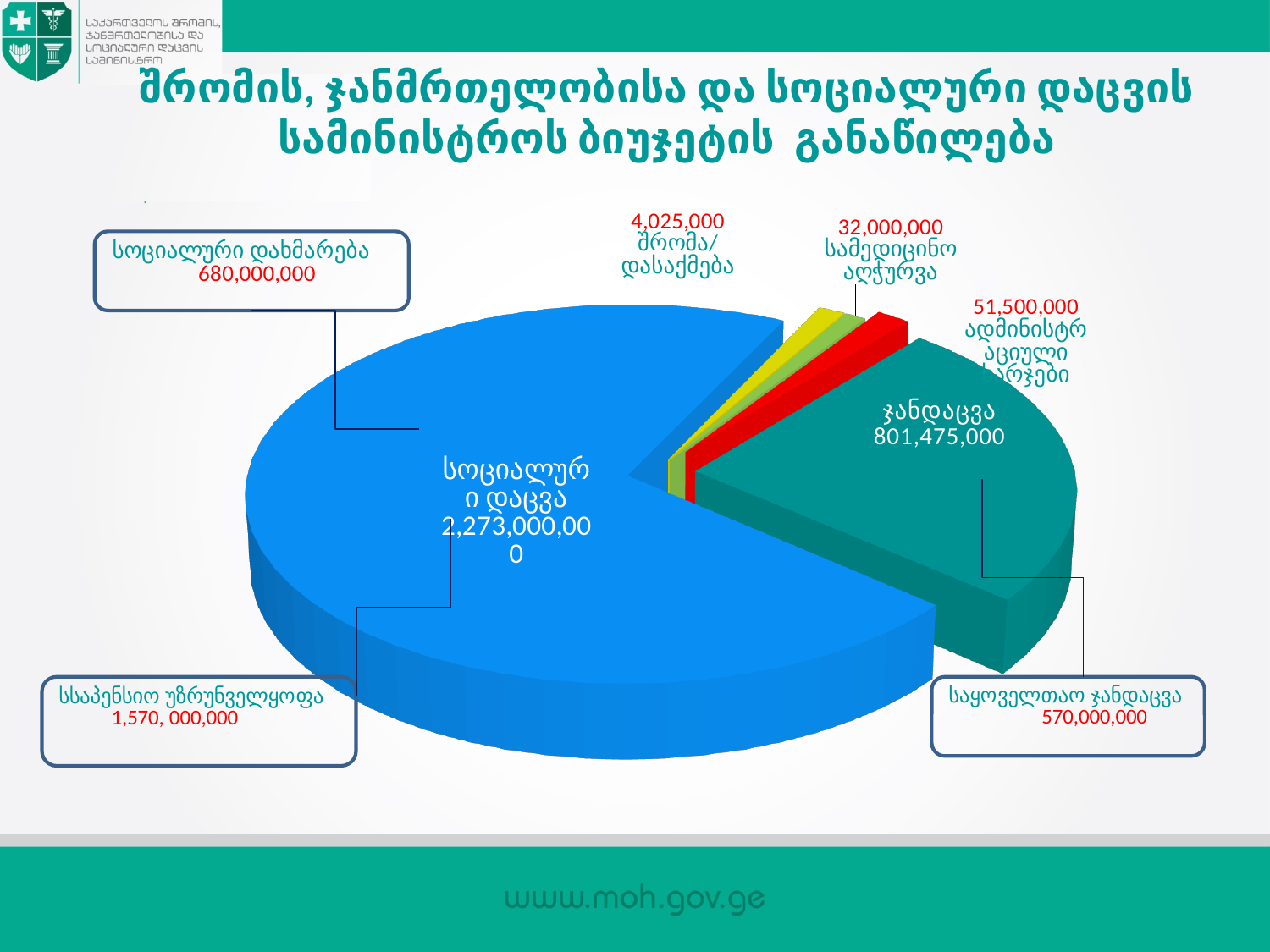
Which is larger, ადმინისტრაციული ხარჯები or სამედიცინო აღჭურვა? ადმინისტრაციული ხარჯები Which slice of the pie chart is the largest? სოციალური დაცვა What is the difference between the სოციალური დაცვა value and the ჯანდაცვა value? 1,471,525,000 What is the value shown for შრომა/დასაქმება? 4,025,000 How many slices does the pie chart have? 5 Which slice of the pie chart is the smallest? შრომა/დასაქმება What is the value shown for სამედიცინო აღჭურვა? 32,000,000 What is the value shown for ადმინისტრაციული ხარჯები? 51,500,000 What value is shown in the callout box for საყოველთაო ჯანდაცვა? 570,000,000 What is the value shown for the ჯანდაცვა slice? 801,475,000 What type of chart is shown on the slide? pie chart What is the value shown for the სოციალური დაცვა slice? 2,273,000,000